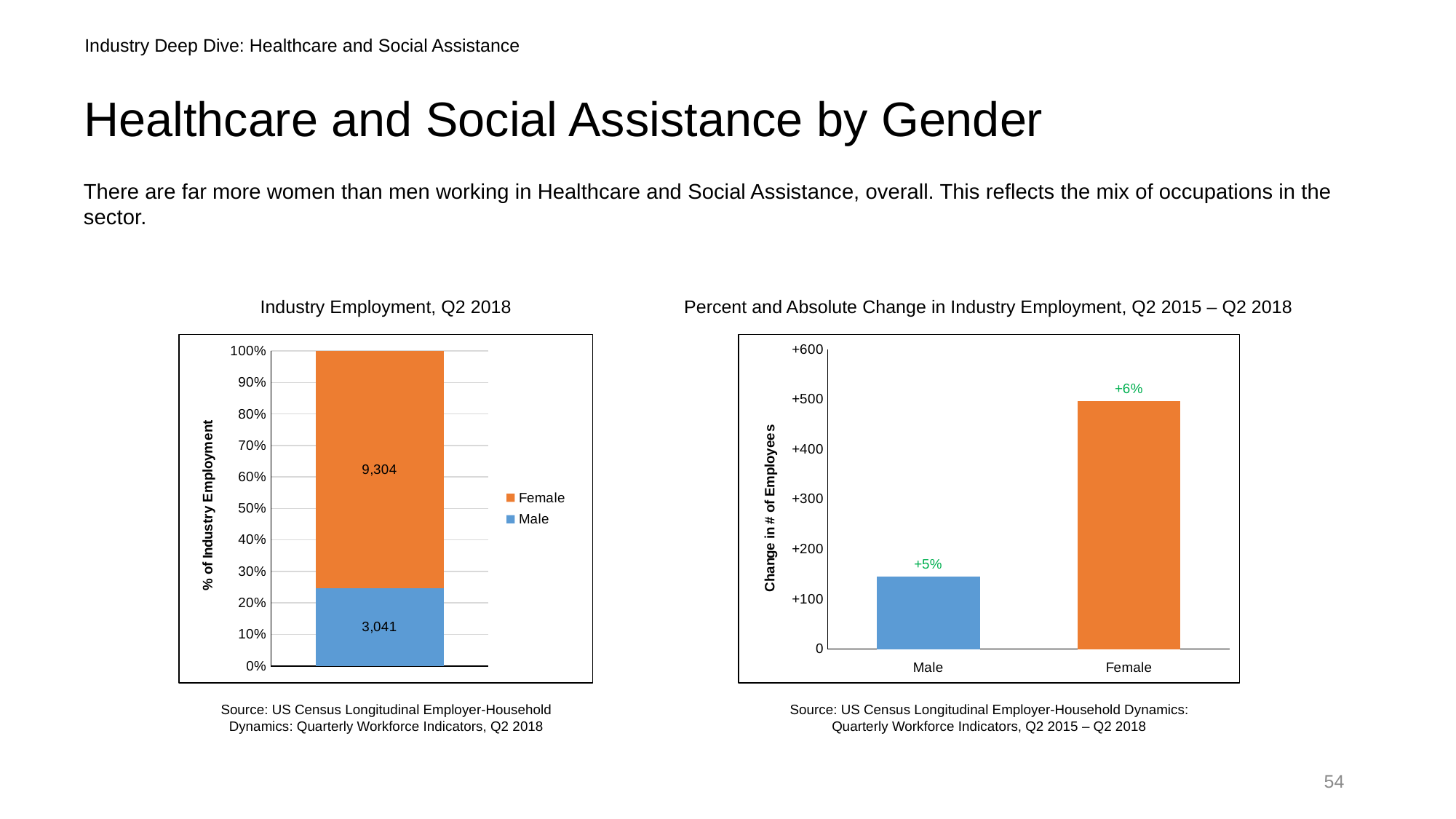
In the 'Percent and Absolute Change in Industry Employment, Q2 2015 – Q2 2018' chart, is the change in number of employees for Male greater or less than +200? less In the 'Percent and Absolute Change in Industry Employment, Q2 2015 – Q2 2018' chart, which category has the highest change in number of employees? Female What kind of chart is the 'Industry Employment, Q2 2018' chart? Stacked bar chart In the 'Industry Employment, Q2 2018' chart, what is the total of the stacked bar? 12,345 In the 'Industry Employment, Q2 2018' chart, how many series does the legend list? 2 In the 'Percent and Absolute Change in Industry Employment, Q2 2015 – Q2 2018' chart, is the change in number of employees for Female greater or less than +400? greater In the 'Industry Employment, Q2 2018' chart, what is the value shown for Female? 9,304 In the 'Industry Employment, Q2 2018' chart, which is larger, the Female or the Male value? Female In the 'Percent and Absolute Change in Industry Employment, Q2 2015 – Q2 2018' chart, what percent change is shown for Male? +5% In the 'Percent and Absolute Change in Industry Employment, Q2 2015 – Q2 2018' chart, what percent change is shown for Female? +6% In the 'Industry Employment, Q2 2018' chart, what is the difference between the Female and Male values? 6,263 In the 'Industry Employment, Q2 2018' chart, what is the value shown for Male? 3,041